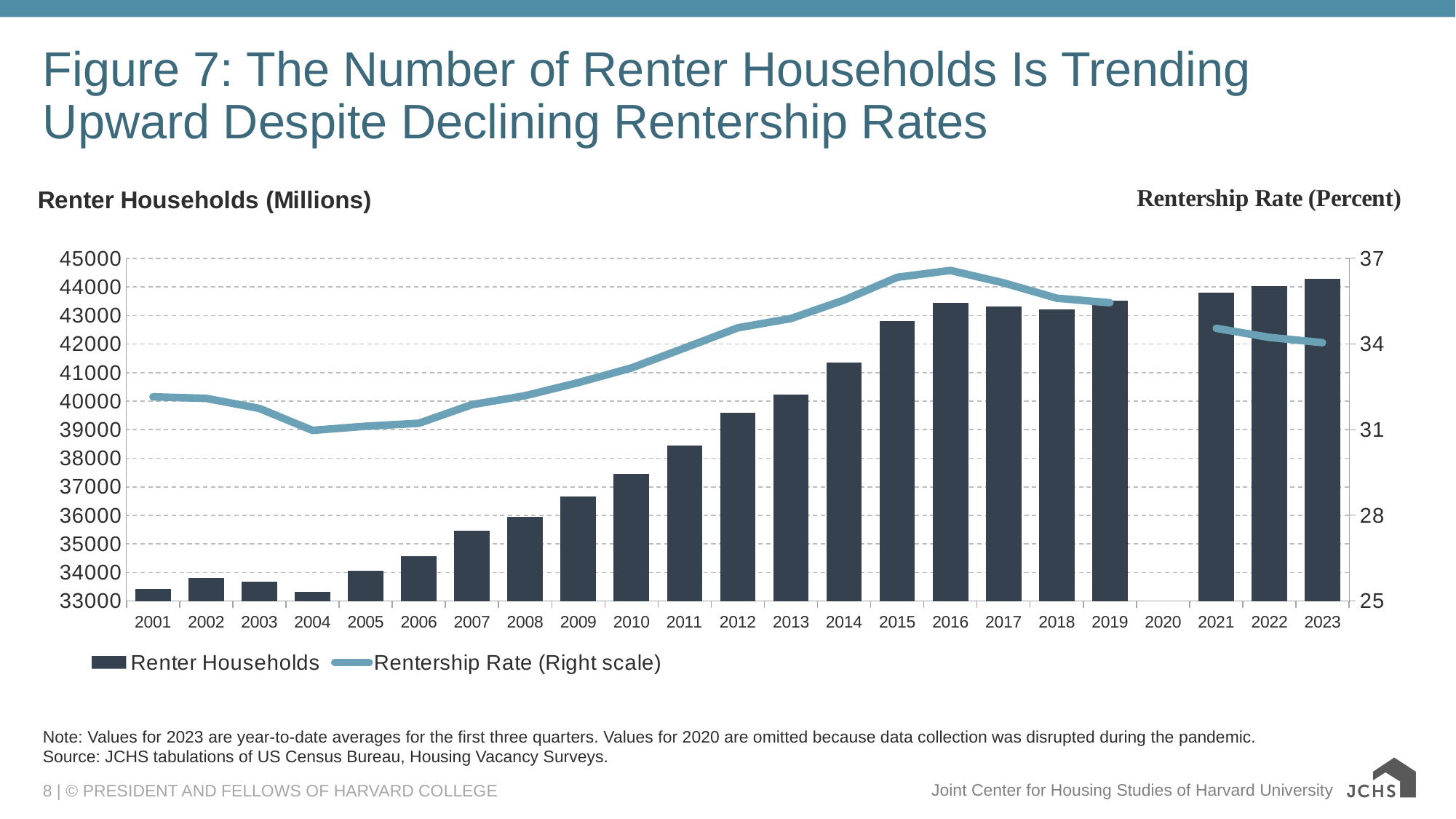
Is the rentership rate in 2004 greater or less than 34? less Which year on the x axis has no bar or line value plotted? 2020 How many year labels appear on the x axis? 23 Which year has more renter households, 2008 or 2012? 2012 Is the number of renter households in 2015 greater or less than 42000? greater Does the rentership rate rise or fall from 2016 to 2023? fall How many series does the legend list? 2 What kind of chart is shown on the slide? A combined bar and line chart In which year does the rentership rate line reach its peak? 2016 Is the rentership rate in 2019 greater or less than 34? greater Which year has the highest number of renter households? 2023